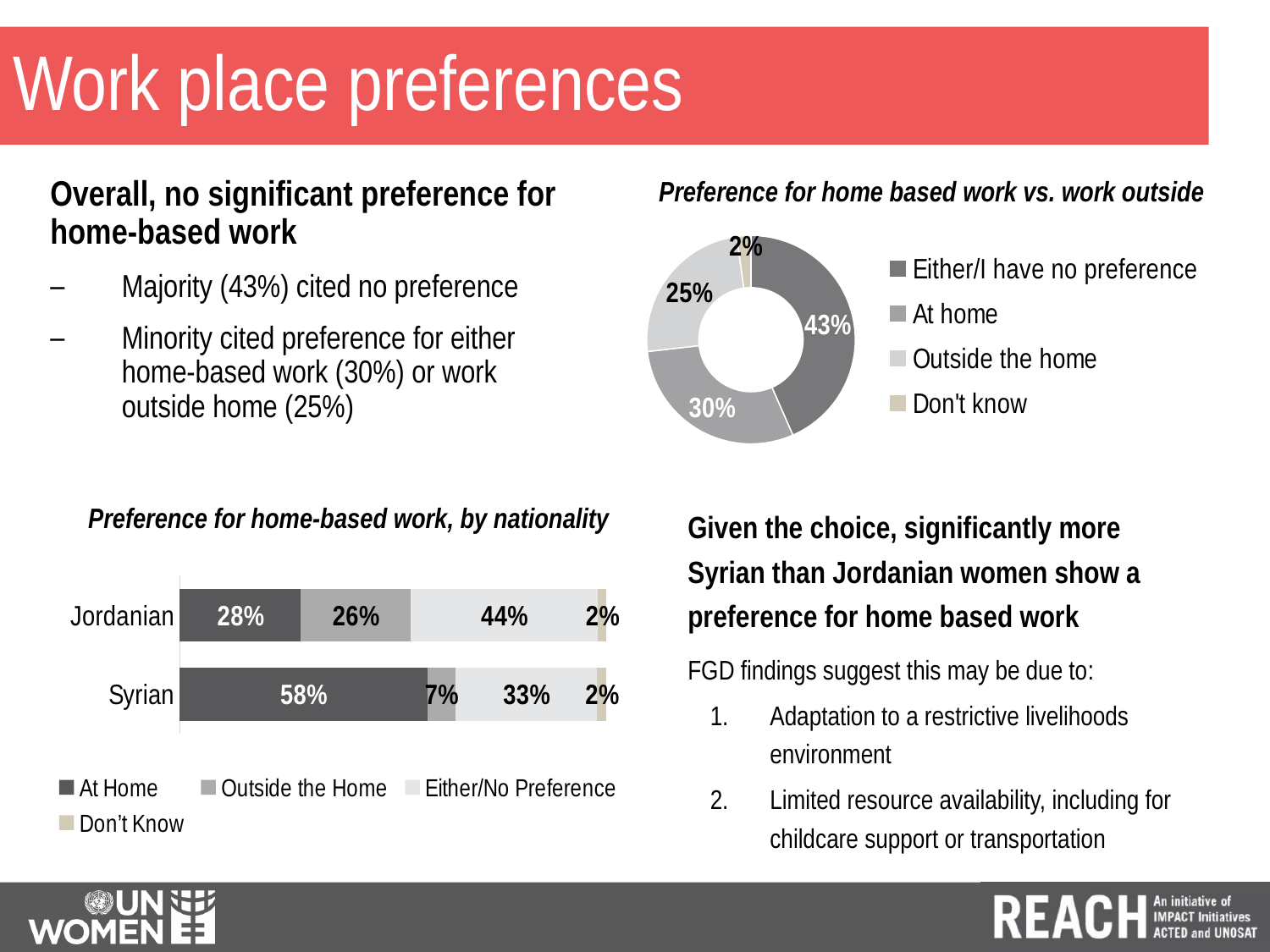
In the 'Preference for home based work vs. work outside' chart, what share of respondents said 'Either/I have no preference'? 43% In the 'Preference for home-based work, by nationality' chart, what is the difference between the Syrian and Jordanian 'At Home' values? 30% In the 'Preference for home based work vs. work outside' chart, how much larger is the 'At home' share than the 'Outside the home' share? 5% How many series does the legend of the 'Preference for home-based work, by nationality' chart list? 4 In the 'Preference for home based work vs. work outside' chart, what share of respondents preferred working at home? 30% In the 'Preference for home based work vs. work outside' chart, how many categories does the legend list? 4 What kind of chart is 'Preference for home based work vs. work outside'? Doughnut chart In the 'Preference for home based work vs. work outside' chart, which category has the smallest share? Don't know In the 'Preference for home-based work, by nationality' chart, which nationality has the higher 'Outside the Home' value? Jordanian In the 'Preference for home-based work, by nationality' chart, what percentage of Syrian women prefer working at home? 58% In the 'Preference for home-based work, by nationality' chart, what percentage of Jordanian women chose 'Either/No Preference'? 44% What kind of chart is 'Preference for home-based work, by nationality'? Stacked bar chart